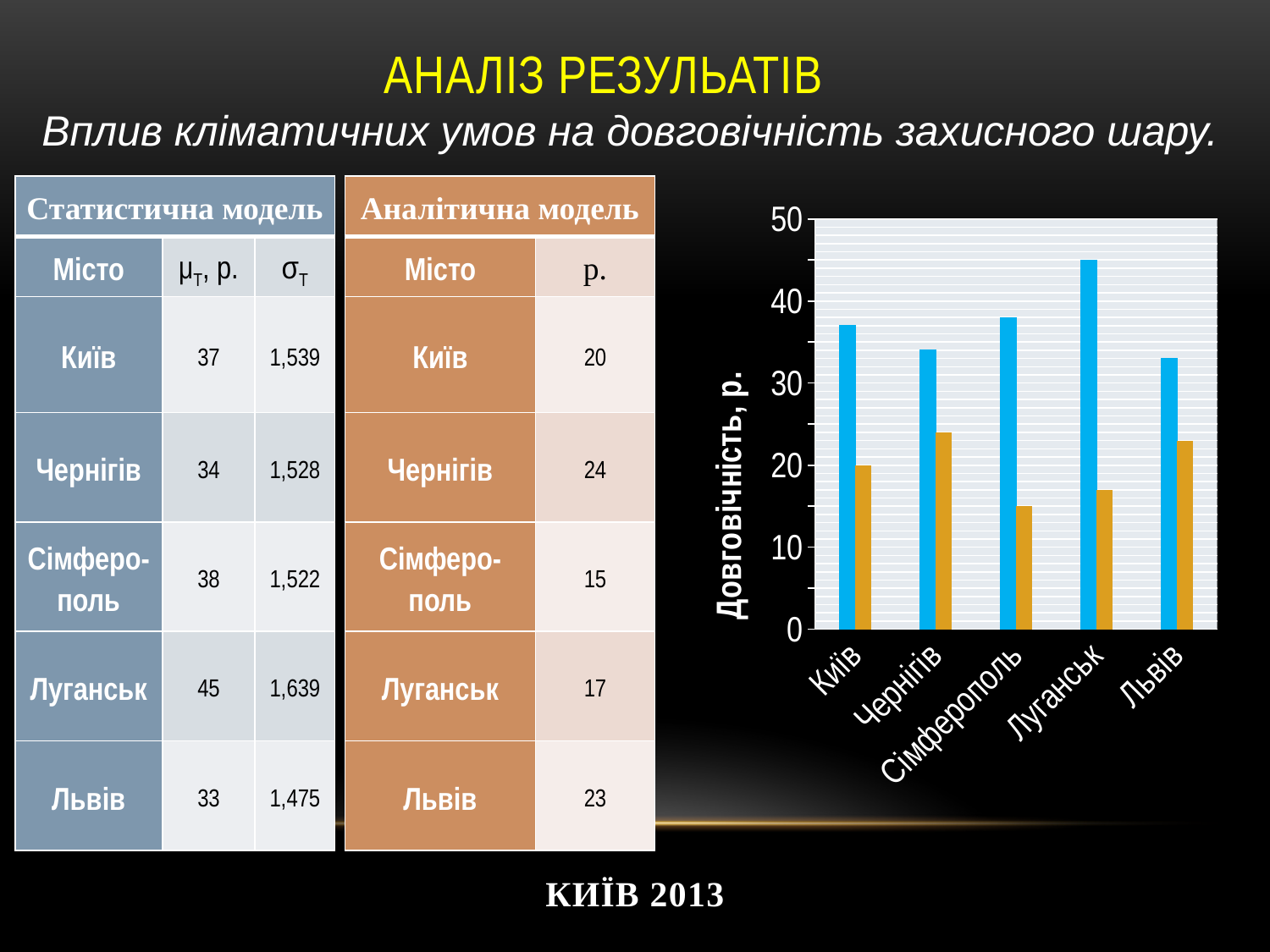
Which city has the tallest blue bar in the chart? Луганськ What kind of chart is shown on the slide? bar chart How many cities are shown on the x axis of the chart? 5 What is the value of the orange bar for Київ? 20 For Київ, which bar is taller, the blue one or the orange one? blue Is the blue bar for Луганськ greater or less than 40? greater Which city has the taller blue bar, Луганськ or Сімферополь? Луганськ Is the blue bar for Чернігів greater or less than 40? less How many bars are plotted for each city in the chart? 2 Is the orange bar for Сімферополь greater or less than 20? less What is the label of the vertical axis of the chart? Довговічність, р.